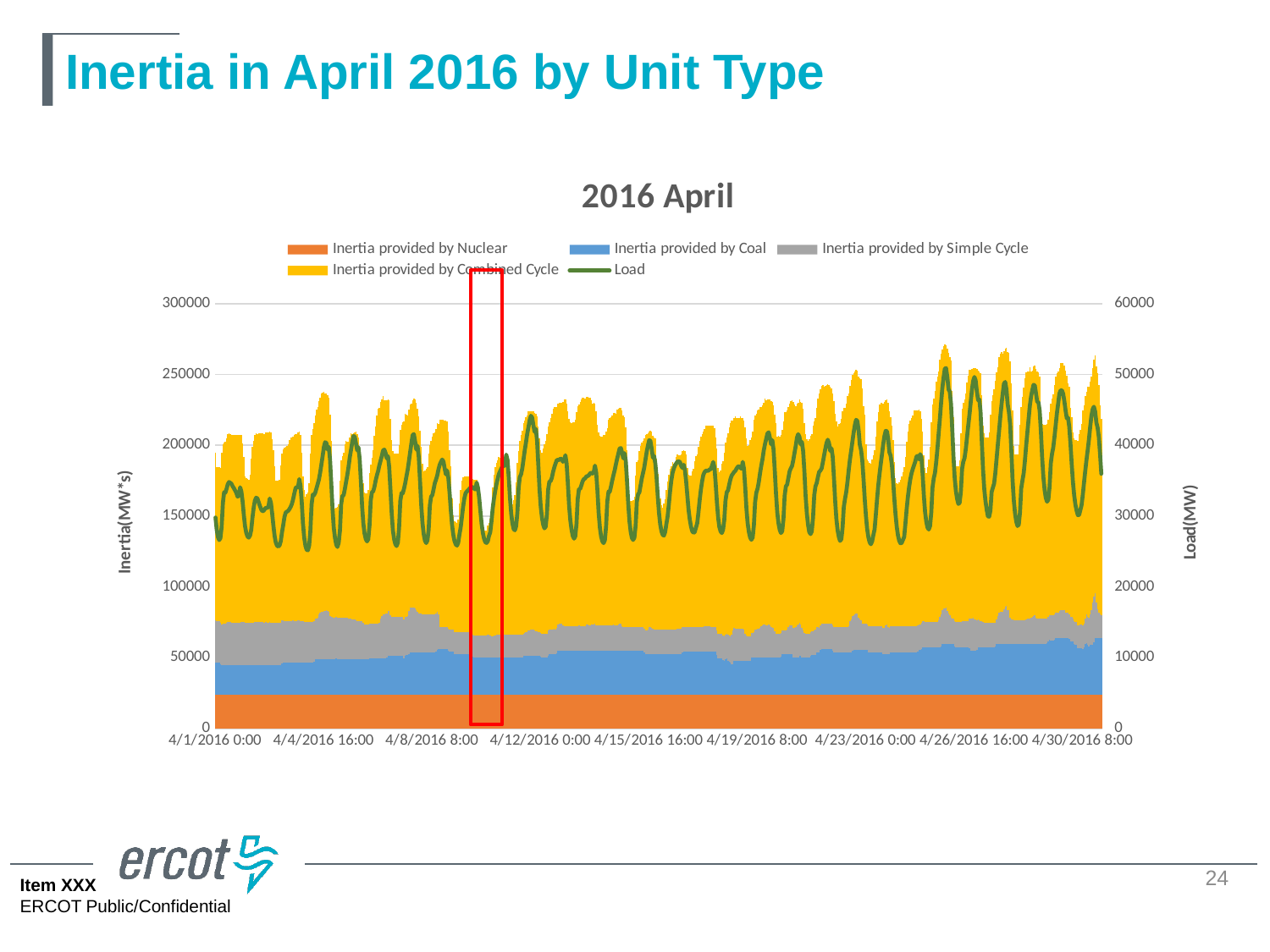
How many series does the legend of the '2016 April' chart list? 5 Is the peak Load around 4/26/2016 greater or less than 40000 MW? greater Is the total inertia at the start of the month (4/1/2016 0:00) greater or less than 150000 MW*s? greater What kind of chart is shown on the slide? Stacked area chart with a line series What is the label of the right-hand vertical axis? Load(MW) Which provides more inertia, Combined Cycle or Coal? Combined Cycle Do the daily Load peaks generally rise or fall over the course of April 2016? rise How many date labels are shown along the x axis? 9 Which unit type provides the largest share of inertia throughout April 2016? Combined Cycle What is the title of the chart on the slide? 2016 April Is the highest total inertia reached during the month greater or less than 300000 MW*s? less